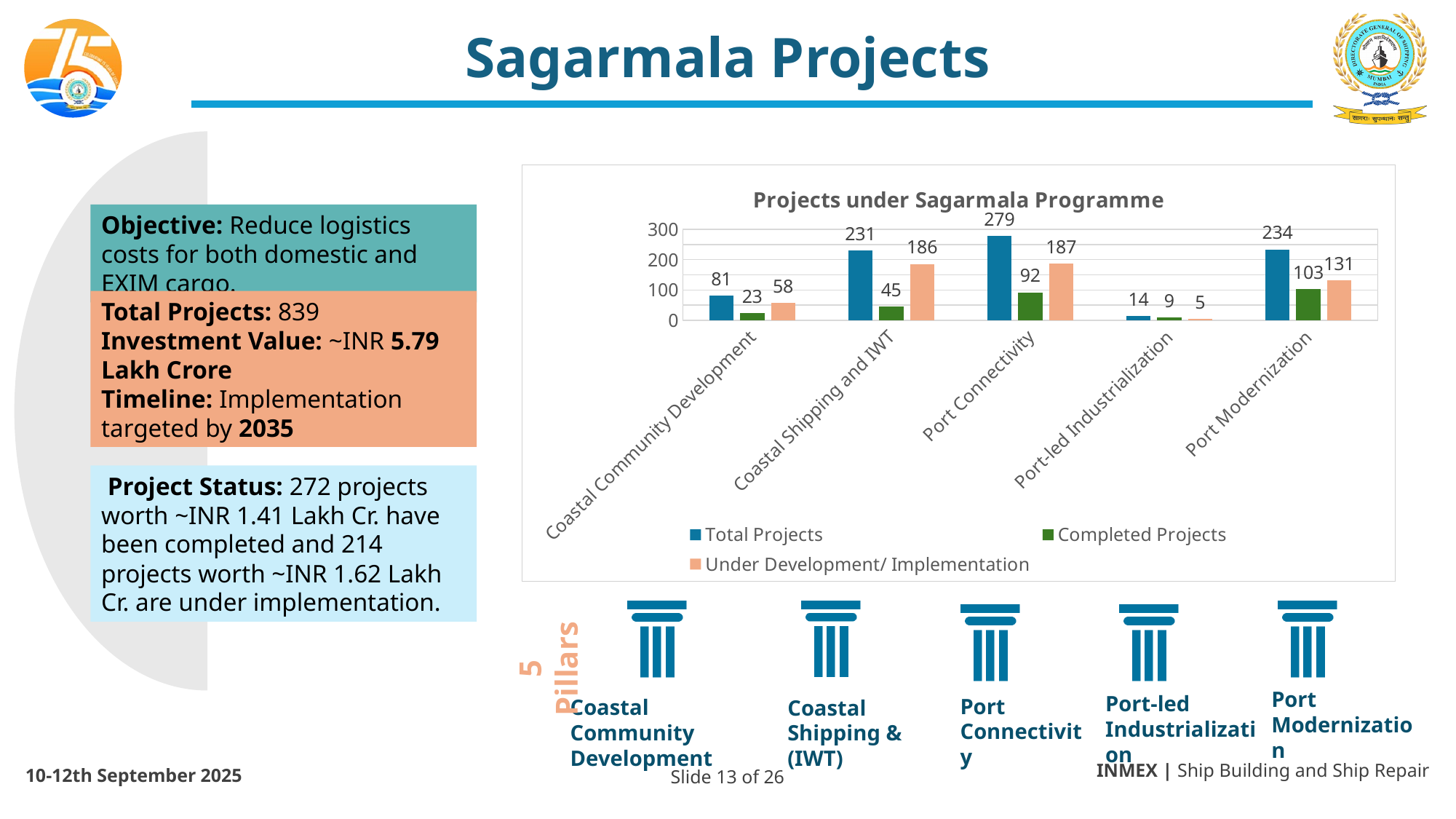
How many Completed Projects are shown for Coastal Shipping and IWT? 45 What kind of chart is shown on the slide? Bar chart How many categories are shown on the x axis of the chart? 5 Is the Total Projects value for Coastal Shipping and IWT greater or less than 200? greater Which is larger for Port Modernization: Completed Projects or Under Development/ Implementation? Under Development/ Implementation Which category has the lowest Completed Projects value? Port-led Industrialization What is the title of the chart? Projects under Sagarmala Programme Which category has the highest Total Projects value? Port Connectivity What is the Under Development/ Implementation value for Port Modernization? 131 How many series does the chart legend list? 3 What is the difference between Total Projects and Completed Projects for Coastal Community Development? 58 What is the value of Total Projects for Port Connectivity? 279